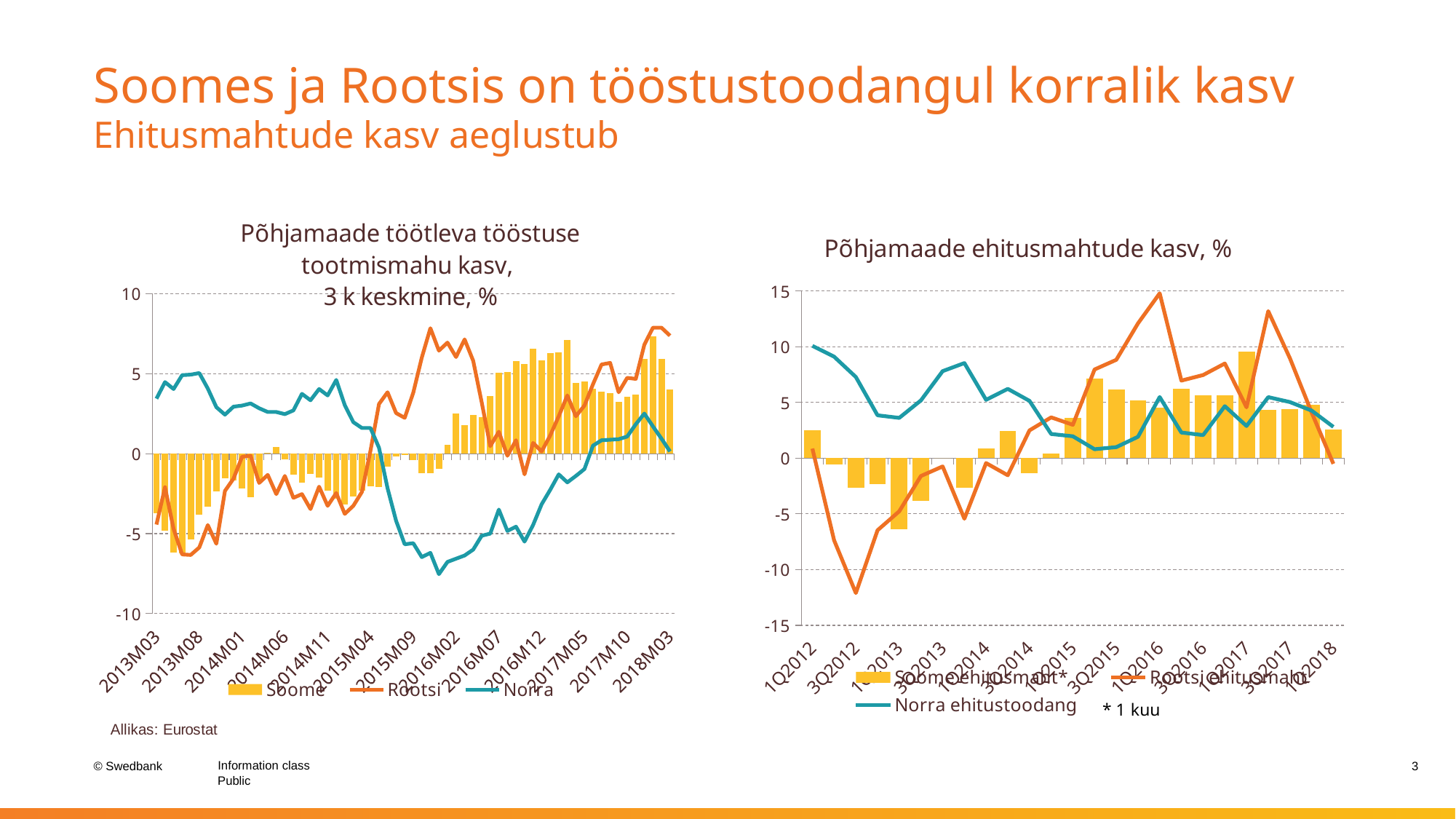
In the left chart, which series is drawn as bars? Soome How many x-axis labels are shown on the right chart? 13 In the left chart, is the Norra value at 2016M02 greater or less than -5? less What kind of chart is the left chart, 'Põhjamaade töötleva tööstuse tootmismahu kasv, 3 k keskmine, %'? Combined bar and line chart In the right chart, is the value of Rootsi ehitusmaht at 3Q2012 greater or less than -10? less How many series does the legend of the right chart, 'Põhjamaade ehitusmahtude kasv, %', list? 3 In the right chart, does the Rootsi ehitusmaht line rise or fall from 1Q2017 to 1Q2018? fall In the right chart, at which x-axis label does the Rootsi ehitusmaht line reach its highest value? 1Q2016 In the right chart, at which x-axis label does the Rootsi ehitusmaht line reach its lowest value? 3Q2012 In the right chart, which series is drawn as bars? Soome ehitusmaht* In the right chart, at 1Q2016, which is larger: Rootsi ehitusmaht or Norra ehitustoodang? Rootsi ehitusmaht In the right chart, is the value of Rootsi ehitusmaht at 1Q2016 greater or less than 10? greater